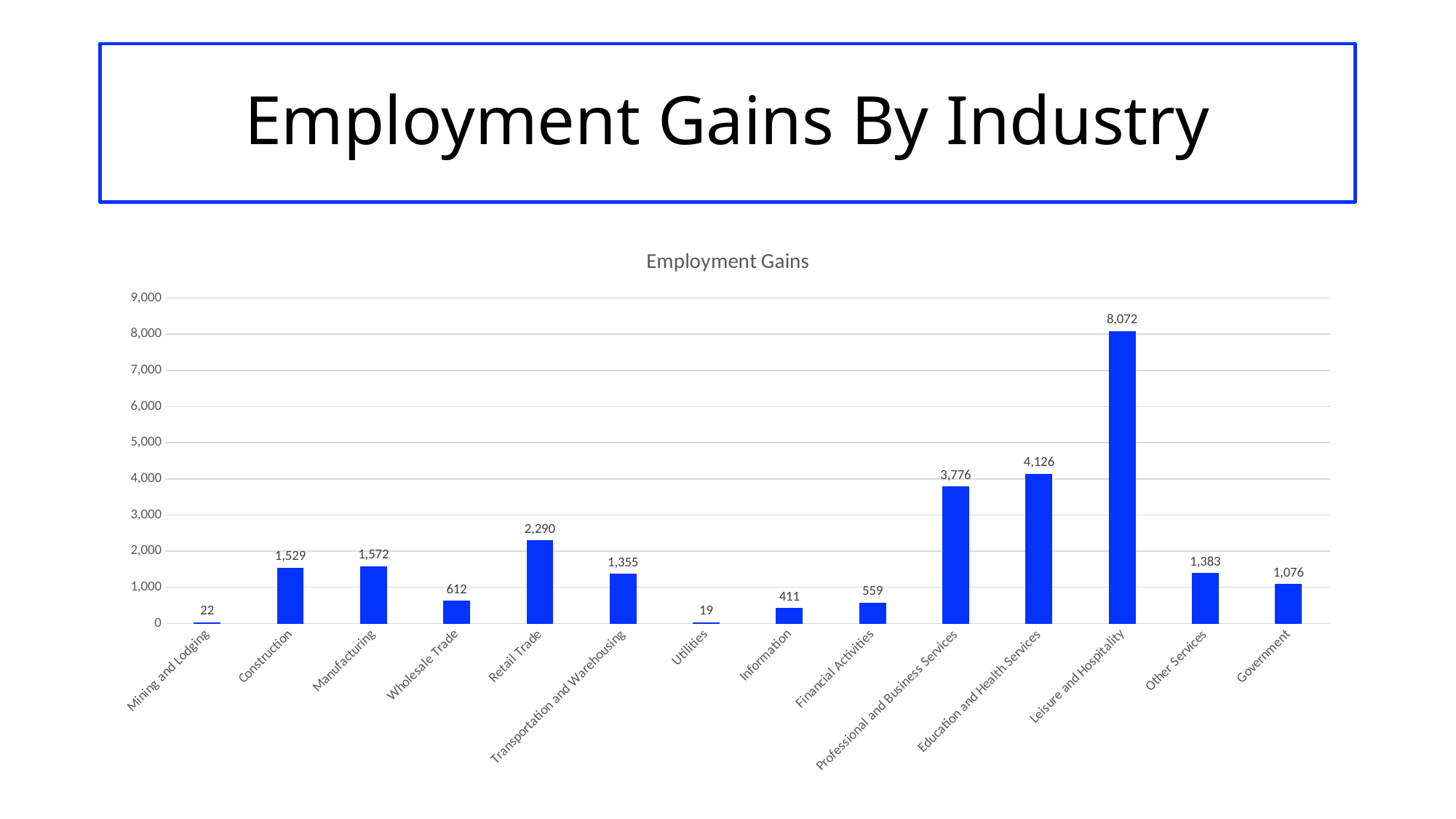
What is the employment gain for Government? 1,076 What kind of chart is shown on the slide? bar chart What is the employment gain for Retail Trade? 2,290 Which industry has the lowest employment gain? Utilities What is the difference between the employment gains for Leisure and Hospitality and Education and Health Services? 3,946 Is the employment gain for Transportation and Warehousing greater or less than 2,000? less Which industry has the highest employment gain? Leisure and Hospitality What is the employment gain for Education and Health Services? 4,126 What is the difference between the employment gains for Construction and Manufacturing? 43 Which has a larger employment gain, Professional and Business Services or Retail Trade? Professional and Business Services How many industries are shown in the chart? 14 What is the title of the chart? Employment Gains